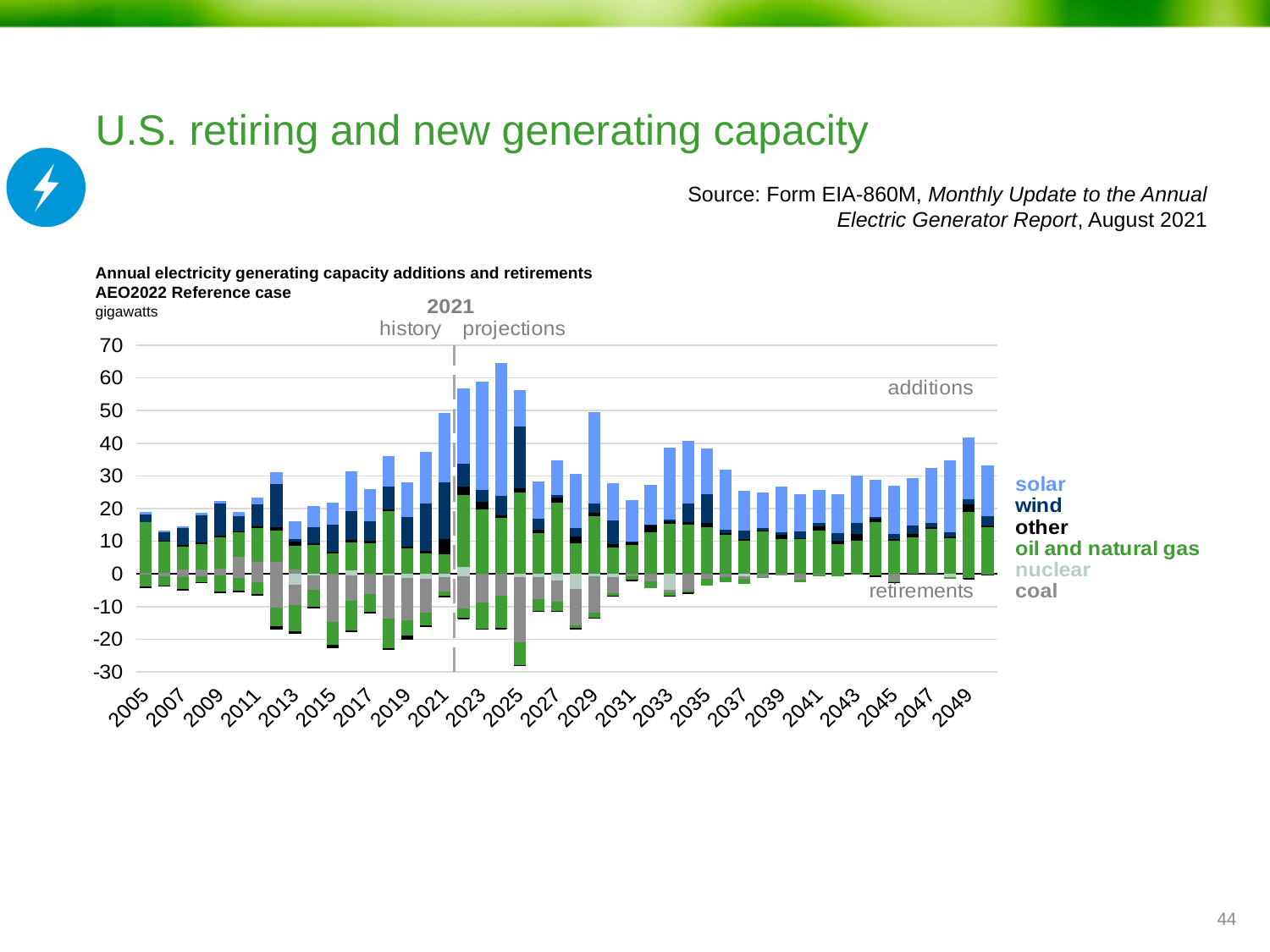
Is the largest retirements bar greater or less than -20 gigawatts? less What unit is the y axis measured in? gigawatts Which year does the dashed vertical line separating history from projections mark? 2021 Is the tallest additions bar greater or less than 60 gigawatts? greater How many year labels are shown on the x axis? 23 Is the additions bar for 2005 greater or less than 30 gigawatts? less Do the retirements bars get larger or smaller in magnitude from 2030 toward 2049? smaller What kind of chart is shown on the slide? stacked bar chart How many series does the legend list? 6 Which series is shown in the lightest blue at the top of the additions bars? solar